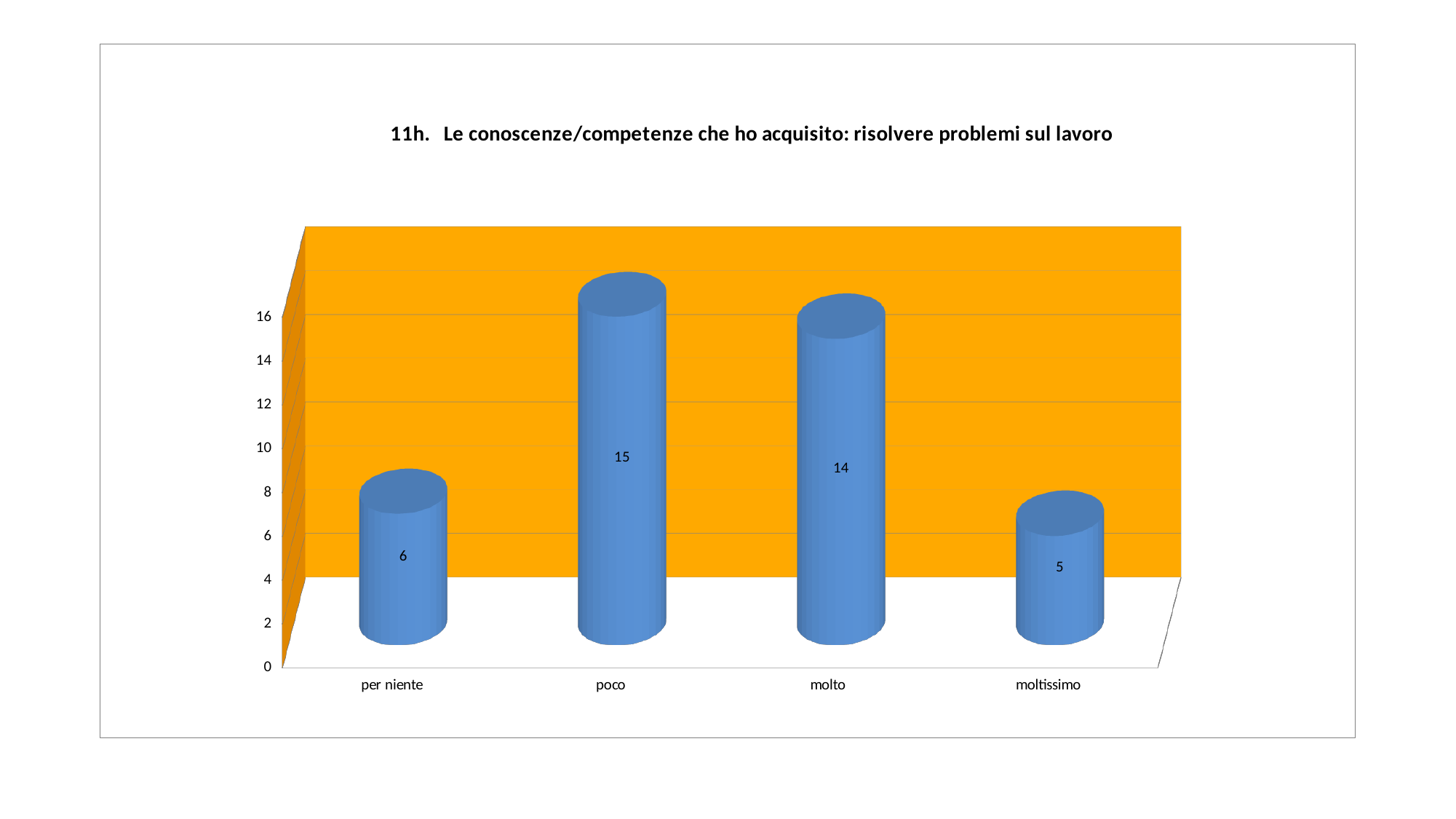
Which category has the lowest value? moltissimo What is the value for "molto"? 14 What is the value for "moltissimo"? 5 What kind of chart is shown on the slide? bar chart How many categories are shown on the x axis? 4 What is the difference between the values for "molto" and "moltissimo"? 9 Which category has the highest value? poco What is the value for "per niente"? 6 Which is larger, the value for "per niente" or the value for "moltissimo"? per niente What is the title of the chart? 11h. Le conoscenze/competenze che ho acquisito: risolvere problemi sul lavoro What is the difference between the values for "poco" and "per niente"? 9 What is the value for "poco"? 15